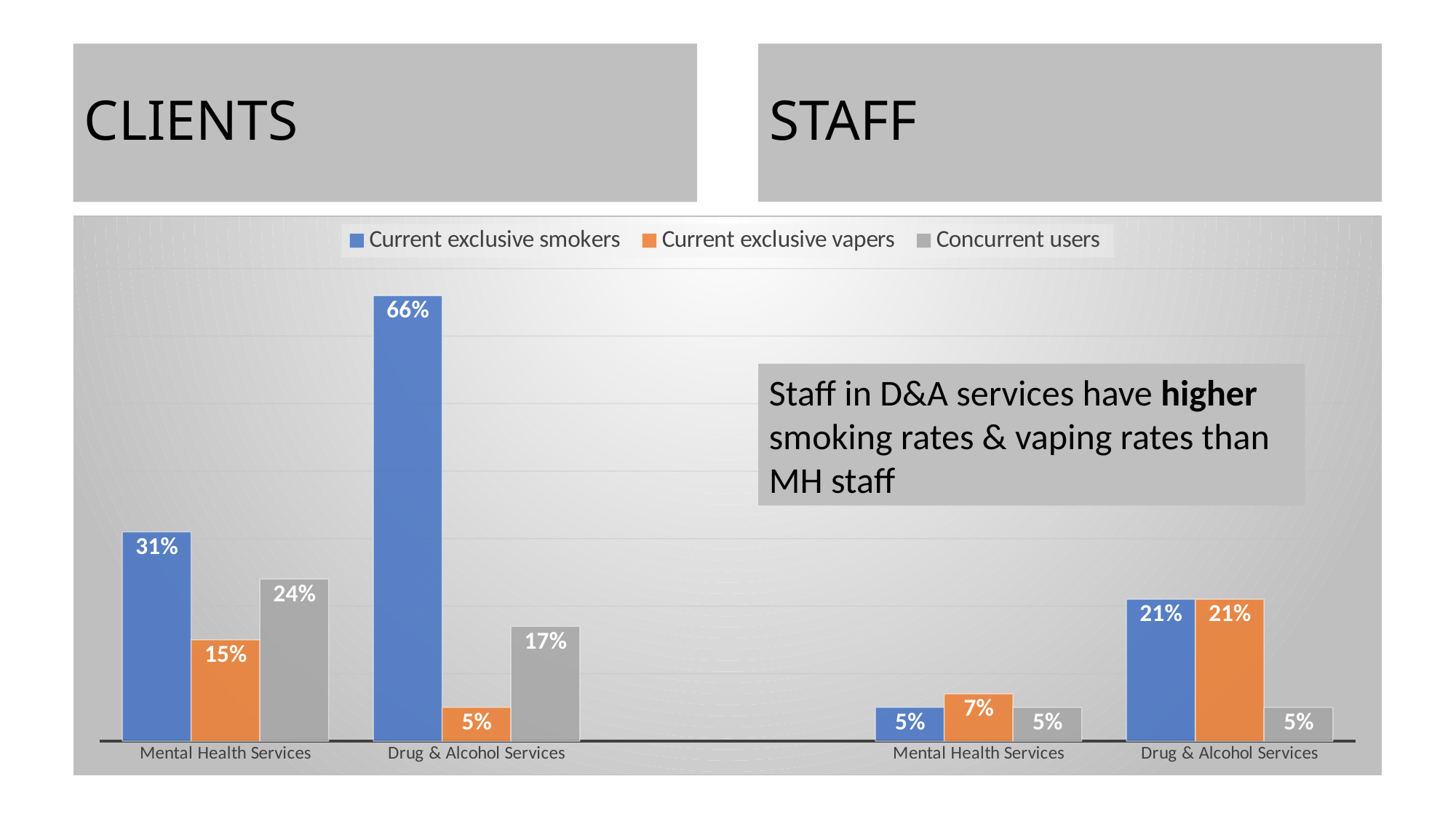
Which is larger: the current exclusive vapers rate for Mental Health Services clients or for Drug & Alcohol Services clients? Mental Health Services clients How many series does the legend list? 3 What is the difference between the current exclusive smokers rate for Drug & Alcohol Services staff and Mental Health Services staff? 16% What kind of chart is shown on the slide? Bar chart What is the difference between the current exclusive smokers rate for Drug & Alcohol Services clients and Mental Health Services clients? 35% What percentage of clients in Drug & Alcohol Services are current exclusive smokers? 66% What percentage of clients in Mental Health Services are concurrent users? 24% What percentage of staff in Mental Health Services are current exclusive vapers? 7% What percentage of staff in Drug & Alcohol Services are current exclusive vapers? 21% Which series is shown in orange in the legend? Current exclusive vapers Which group has the highest value for current exclusive smokers? Drug & Alcohol Services clients What is the concurrent users rate for Drug & Alcohol Services clients? 17%